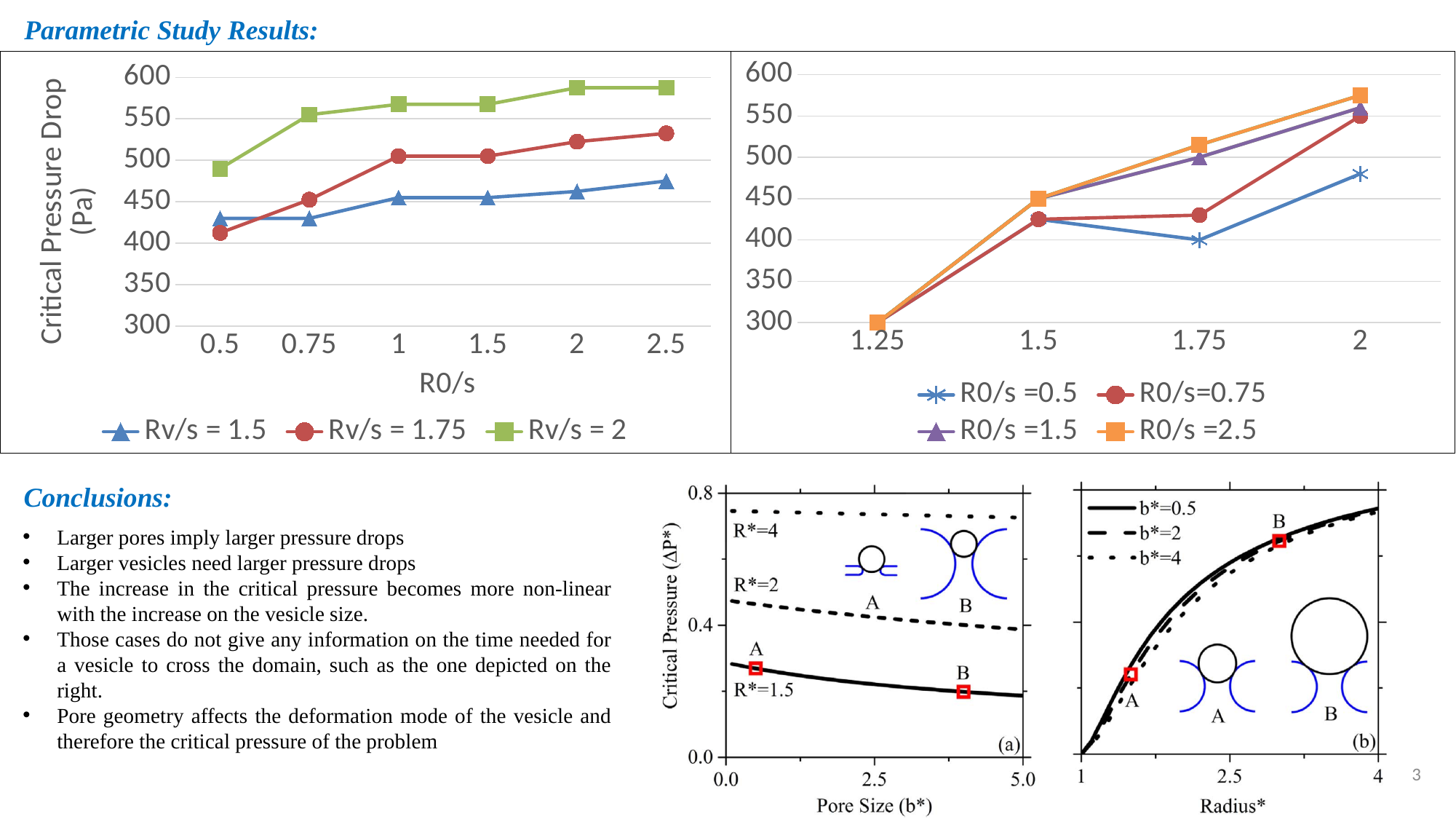
In the right chart, is the value for R0/s =0.5 at x = 1.75 greater or less than 450? less In the left chart, at R0/s = 1, which is larger: Rv/s = 1.75 or Rv/s = 1.5? Rv/s = 1.75 How many series does the legend of the left chart list? 3 In the left chart, is the value for Rv/s = 1.5 at R0/s = 2.5 greater or less than 500? less In the left chart, which series has the highest critical pressure drop across all R0/s values? Rv/s = 2 In the right chart, which series has the lowest value at x = 2? R0/s =0.5 How many R0/s values are plotted along the x axis of the left chart? 6 In the left chart, is the value for Rv/s = 2 at R0/s = 0.5 greater or less than 450? greater How many series does the legend of the right chart list? 4 In the left chart, does the Rv/s = 2 series generally rise or fall as R0/s increases? rise How many x-axis points are plotted in the right chart? 4 What kind of chart is the left chart on the slide? line chart